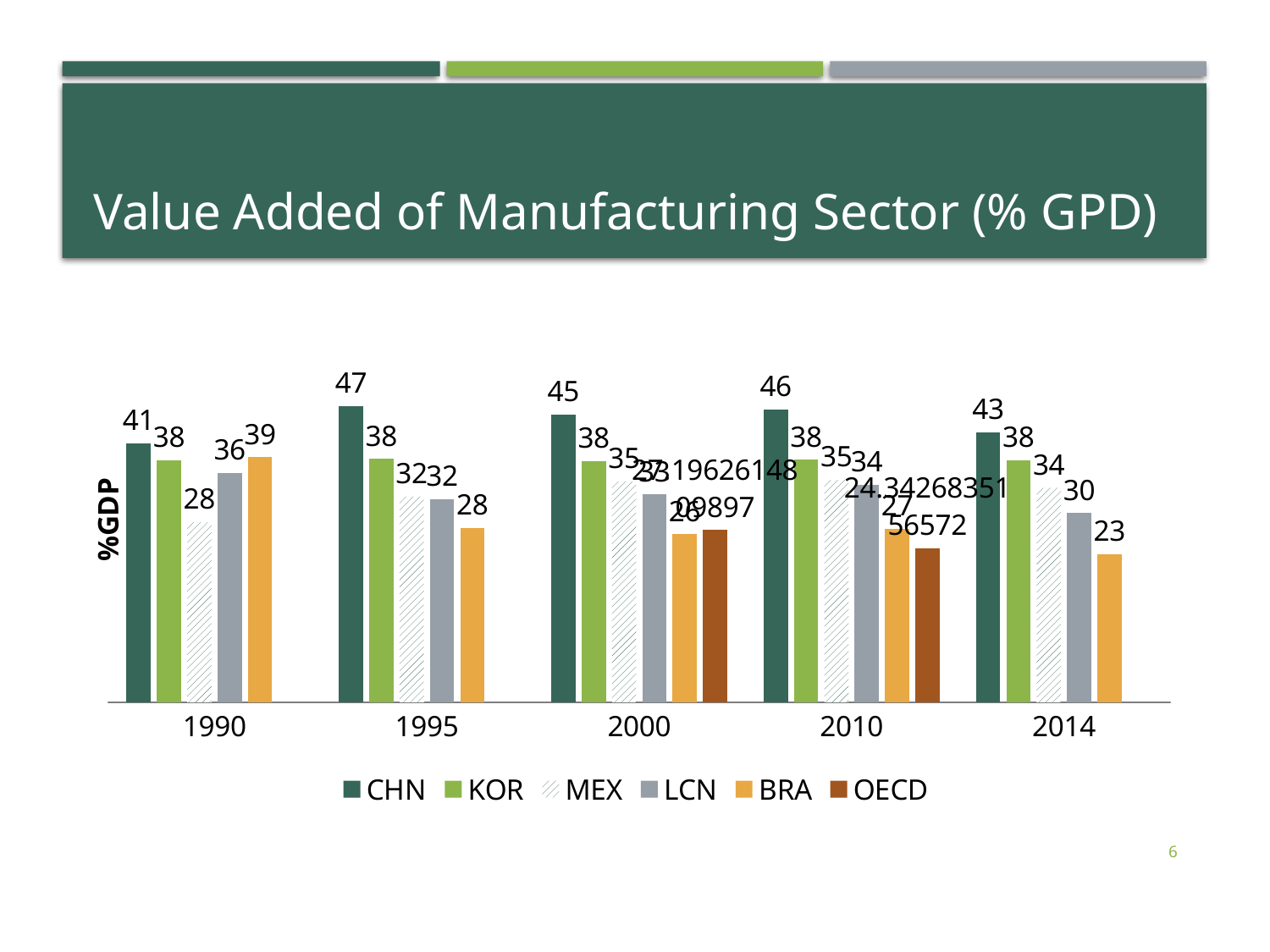
What is the value for CHN in 2010? 46 What kind of chart is shown on the slide? Bar chart How many years are shown on the x axis? 5 What is the value for BRA in 1995? 28 What is the value for LCN in 2014? 30 What is the value for CHN in 1990? 41 How many series does the legend list? 6 Which series has the highest value in 1995? CHN What is the difference between the CHN and BRA values in 1995? 19 Which series has the lowest value in 1990? MEX Does the value for BRA rise or fall from 1990 to 2014? Fall Which is larger in 1990, the value for BRA or the value for KOR? BRA